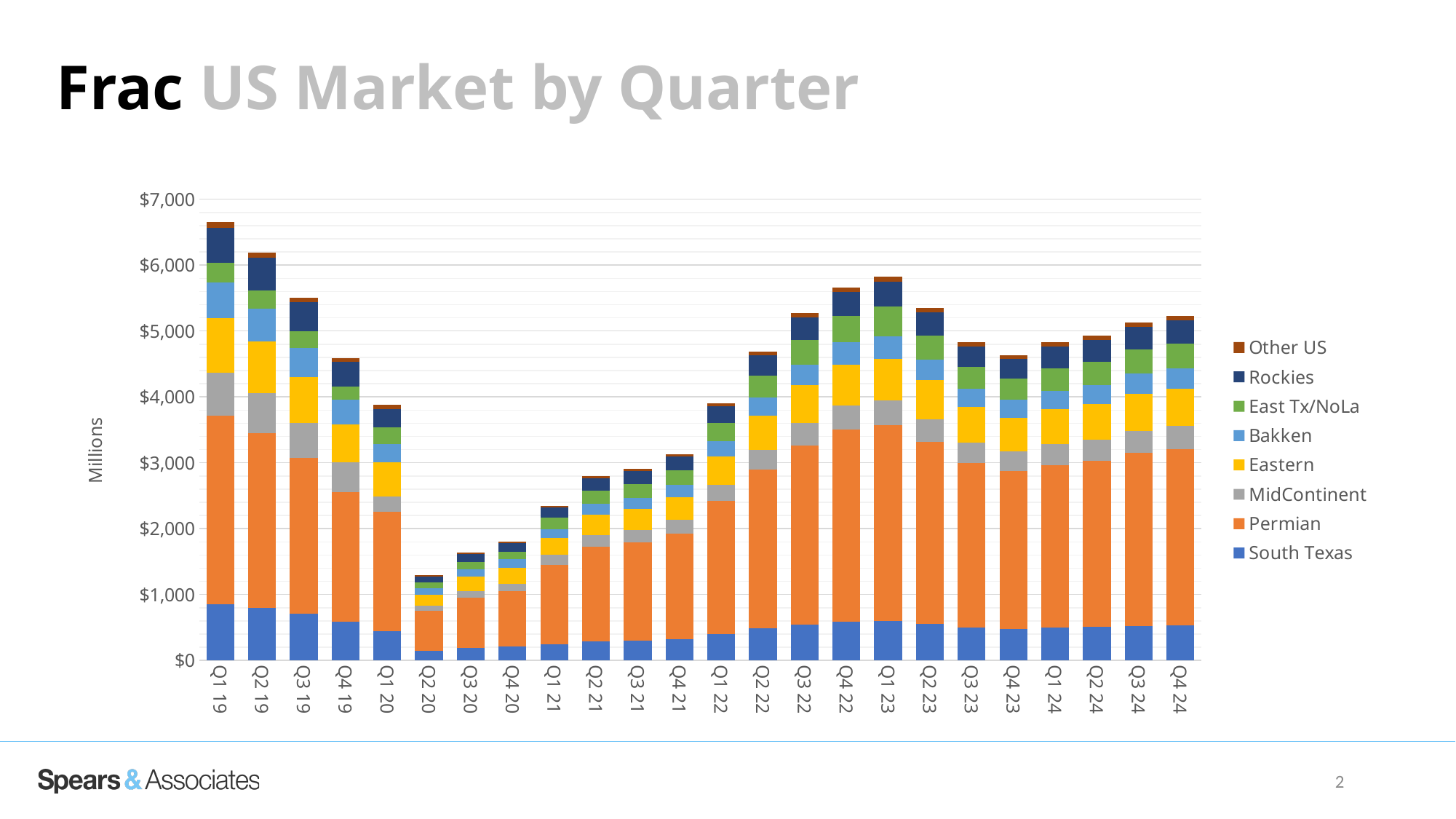
How many quarters are plotted along the x axis? 24 Which quarter has the larger total bar, Q1 19 or Q1 23? Q1 19 Is the total value for Q1 19 greater or less than $6,000? greater Do the total bar values rise or fall from Q1 19 to Q2 20? Fall Is the total value for Q2 20 greater or less than $2,000? less What is the label on the vertical axis? Millions Which series is shown in orange in the legend? Permian What kind of chart is shown on the slide? Stacked bar chart How many series does the legend list? 8 Which quarter has the highest total bar? Q1 19 Which quarter has the lowest total bar? Q2 20 Is the total value for Q2 22 greater or less than $5,000? less